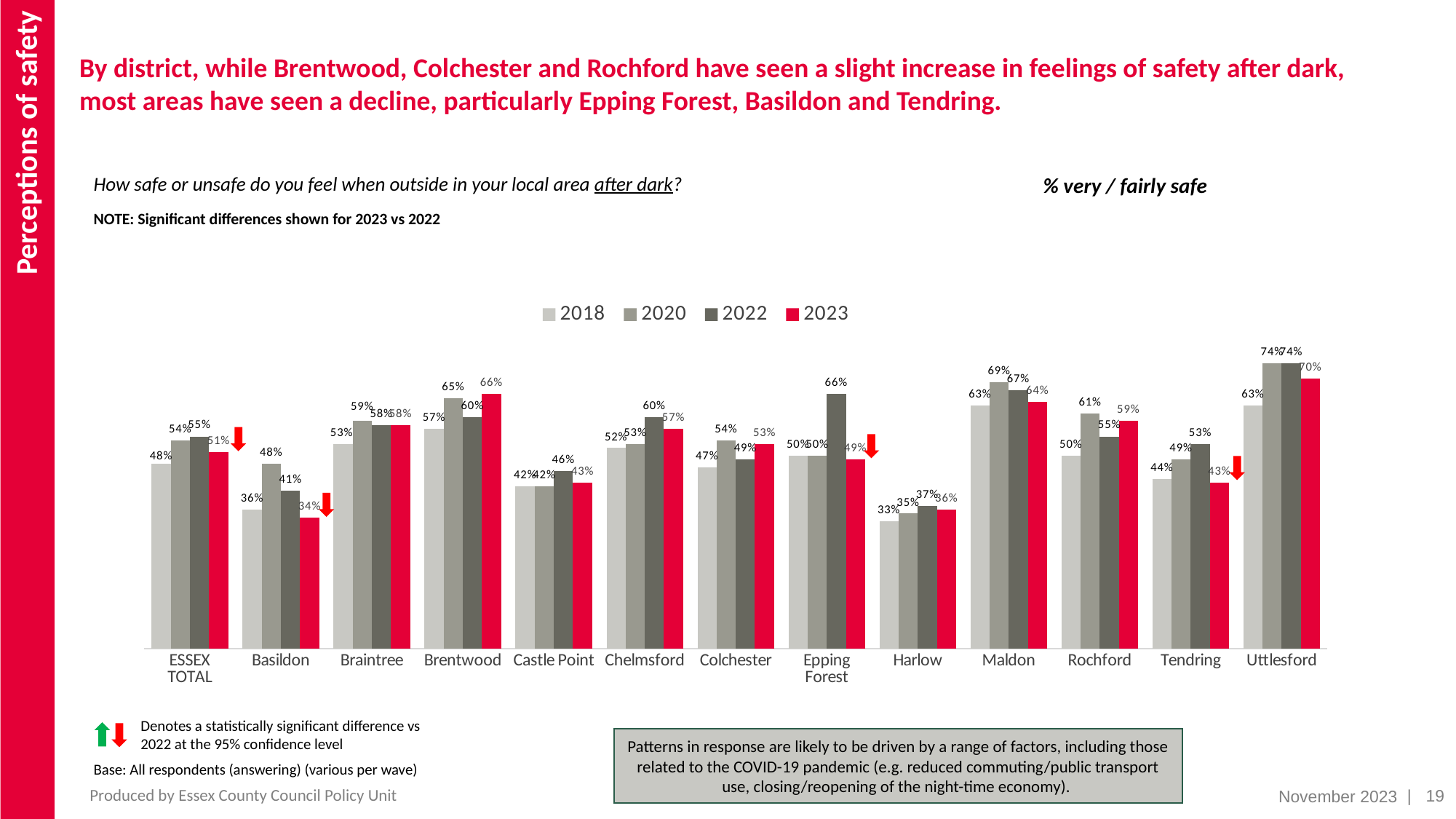
How many series does the legend list? 4 How many districts or categories are shown on the x axis? 13 What kind of chart is shown on the slide? Bar chart Which is larger for Brentwood: the 2020 value or the 2023 value? 2023 Which district has the lowest 2018 value? Harlow What is the 2020 value for Rochford? 61% What is the difference between the 2022 and 2023 values for Tendring? 10% Which colour represents the 2023 series in the legend? Red Do the values for Harlow rise or fall from 2018 to 2022? Rise Which district has the highest 2023 value? Uttlesford What is the 2022 value for Epping Forest? 66% What is the 2023 value for Basildon? 34%